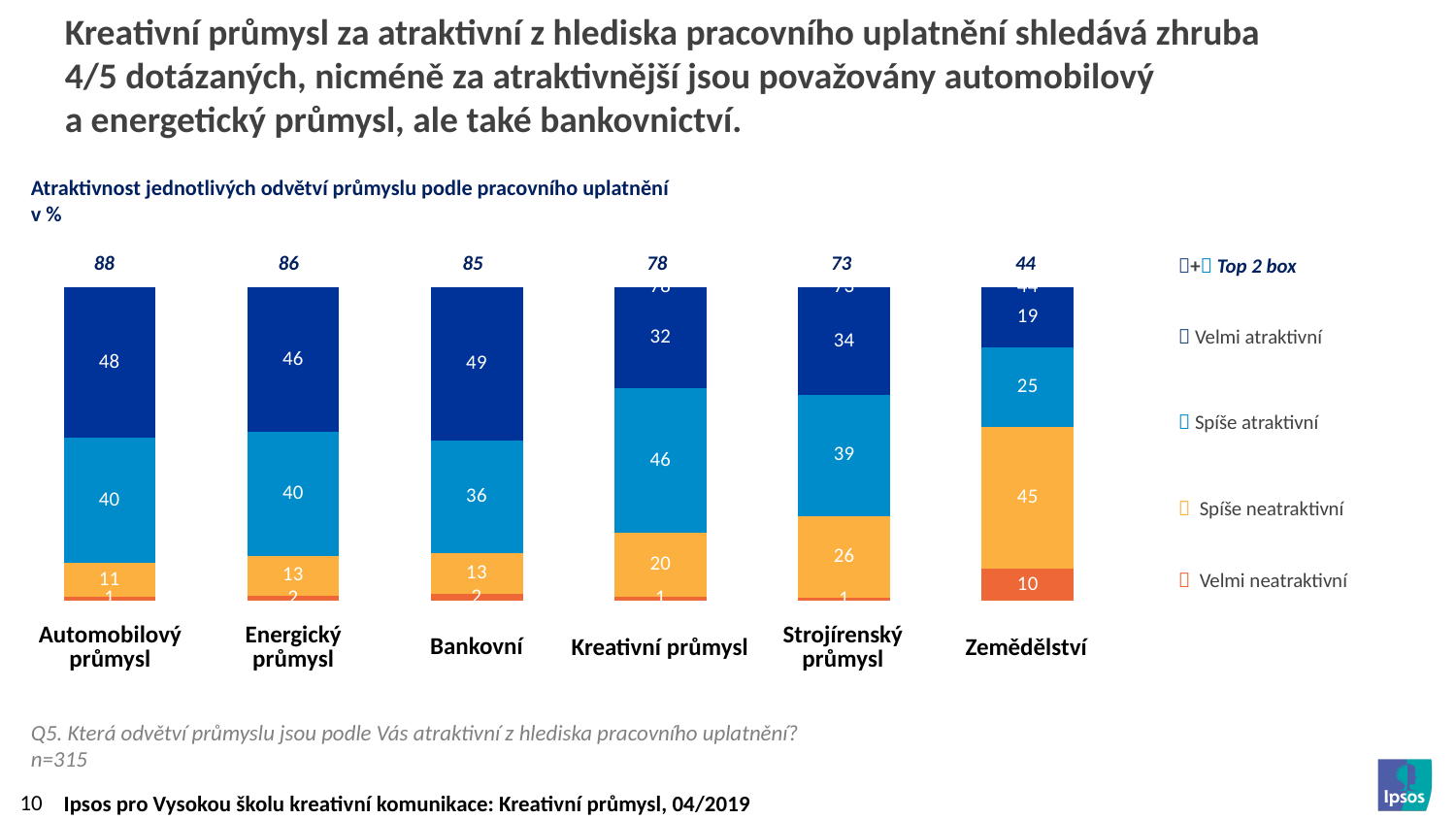
What is the 'Velmi atraktivní' value for Bankovní? 49 What is the Top 2 box value for Automobilový průmysl? 88 Which is larger: the 'Spíše neatraktivní' value for Strojírenský průmysl or for Energický průmysl? Strojírenský průmysl What is the 'Spíše atraktivní' value for Kreativní průmysl? 46 How many categories (industries) are shown on the chart? 6 Which category has the highest 'Velmi atraktivní' value? Bankovní What is the difference between the Top 2 box values of Automobilový průmysl and Kreativní průmysl? 10 What kind of chart is shown on the slide? Stacked bar chart Which category has the lowest Top 2 box value? Zemědělství How many response categories does the legend list (excluding Top 2 box)? 4 What is the 'Velmi neatraktivní' value for Zemědělství? 10 What is the 'Spíše neatraktivní' value for Zemědělství? 45